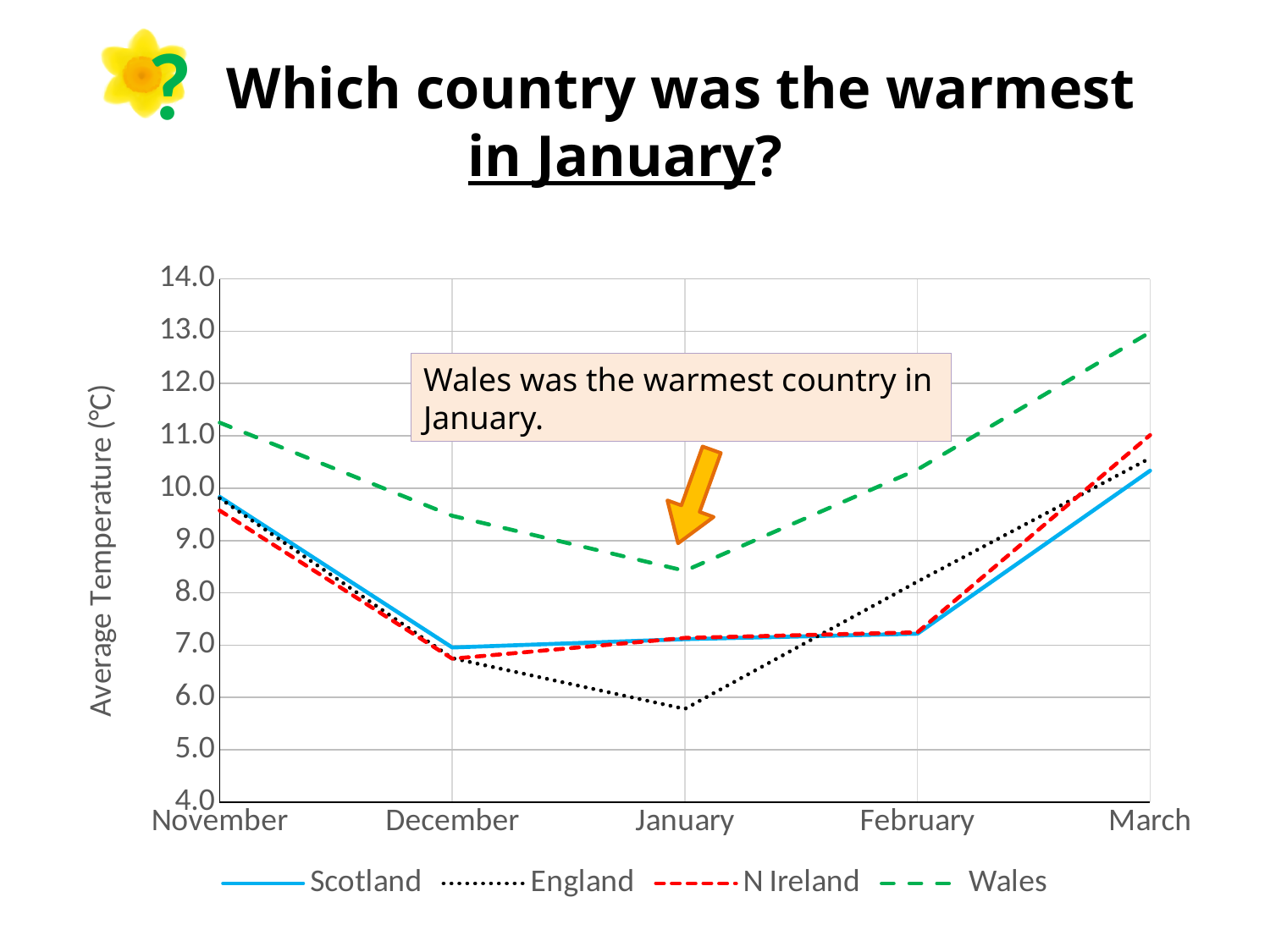
Does the Wales line rise or fall from November to January? fall Is the value for Wales in January greater or less than 8.0? greater Is the value for Wales in March greater or less than 12.0? greater How many months are shown along the x axis? 5 What kind of chart is shown on the slide? line chart How many series does the legend list? 4 In December, which is higher: Wales or England? Wales Is the value for England in January greater or less than 6.0? less Which country has the highest average temperature in January? Wales What is the title of the vertical axis? Average Temperature (°C) Does the England line rise or fall from January to March? rise Which country has the lowest average temperature in January? England